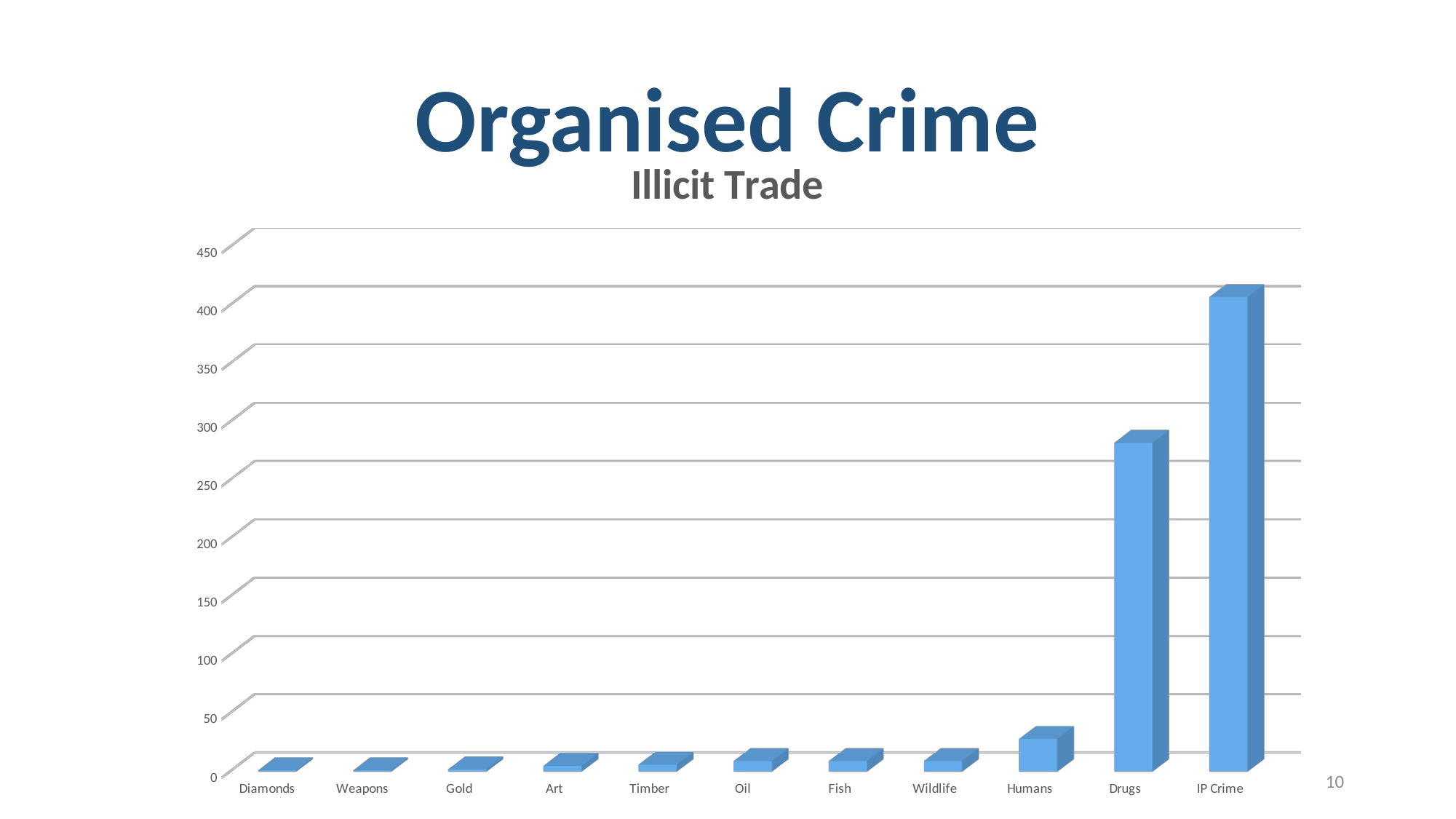
What is the subtitle shown above the chart? Illicit Trade How many categories are shown on the x axis of the chart? 11 Which is larger, the value for Drugs or the value for Humans? Drugs Is the value for Drugs greater or less than 250? greater What kind of chart is shown on the slide? bar chart Is the value for IP Crime greater or less than 350? greater Is the value for Drugs greater or less than 300? less Which category has the highest bar in the chart? IP Crime Do the bar values generally rise or fall from left to right along the x axis? rise Which is larger, the value for IP Crime or the value for Drugs? IP Crime